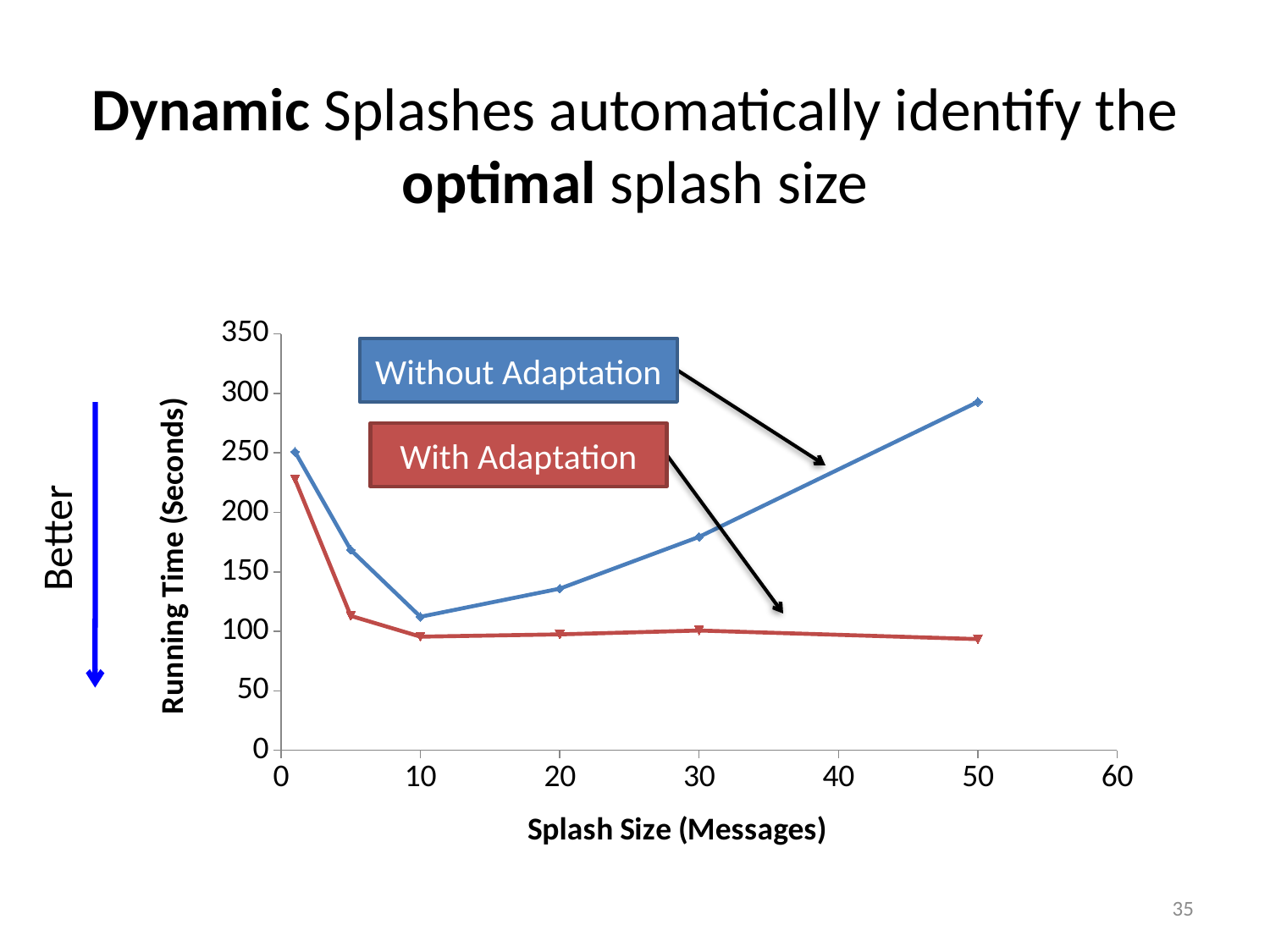
How many data points does the Without Adaptation series have? 6 At which splash size does the Without Adaptation series reach its highest running time? 50 What kind of chart is shown on the slide? line chart At splash size 50, which series has the higher running time, Without Adaptation or With Adaptation? Without Adaptation Is the With Adaptation running time at splash size 50 greater or less than 150? less What is the title of the y axis? Running Time (Seconds) How many series are plotted on the chart? 2 Is the Without Adaptation running time at splash size 30 greater or less than 150? greater What are the names of the two series plotted on the chart? Without Adaptation and With Adaptation Does the Without Adaptation running time rise or fall as splash size increases from 10 to 50? rise At which splash size does the Without Adaptation series reach its lowest running time? 10 Is the Without Adaptation running time at splash size 50 greater or less than 250? greater